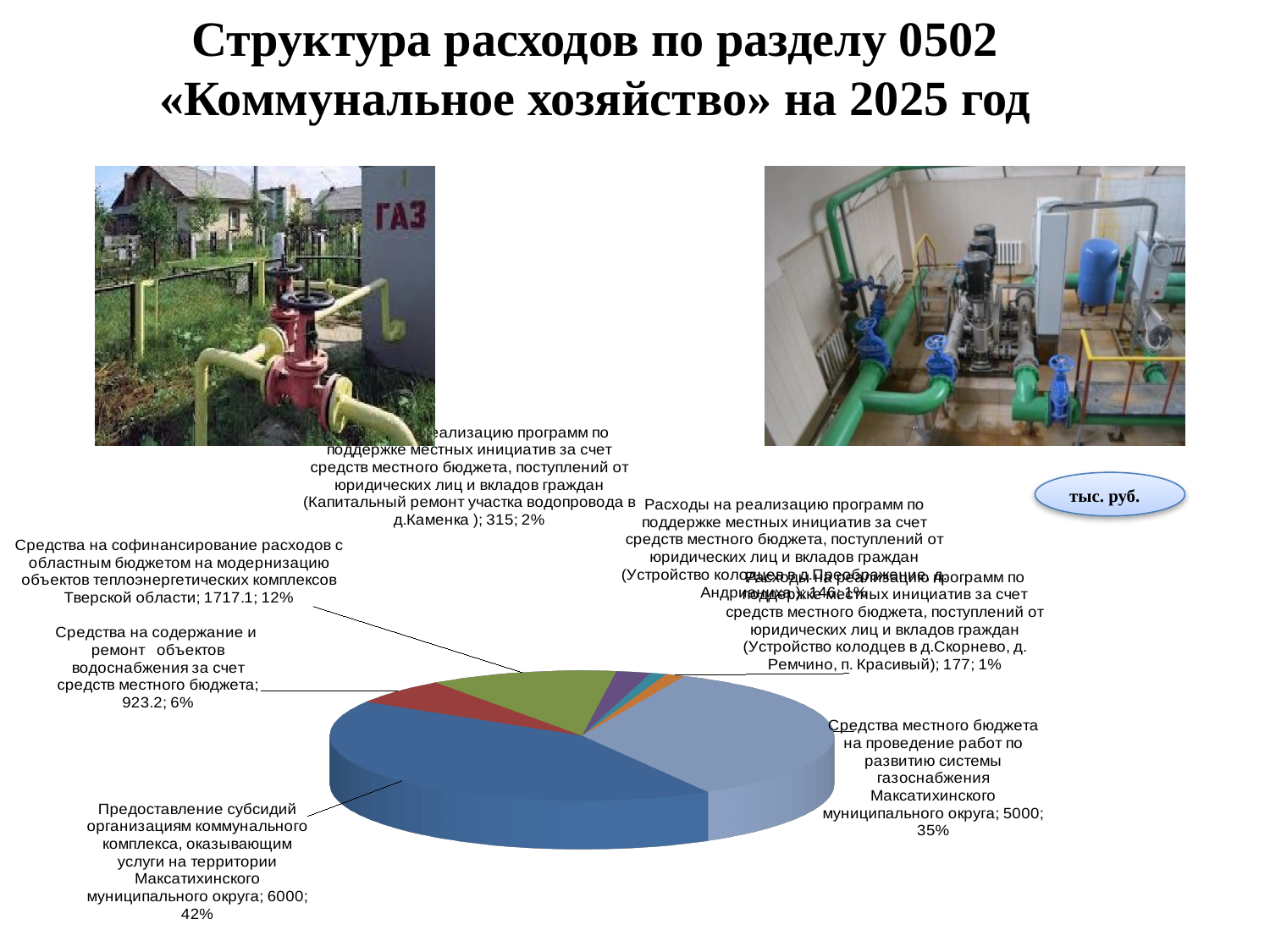
What is the difference between the value for «Предоставление субсидий организациям коммунального комплекса» and the value for «Средства местного бюджета на проведение работ по развитию системы газоснабжения»? 1000 What share of the pie does «Средства местного бюджета на проведение работ по развитию системы газоснабжения Максатихинского муниципального округа» represent? 35% What is the value for «Средства на софинансирование расходов с областным бюджетом на модернизацию объектов теплоэнергетических комплексов Тверской области»? 1717.1 What is the value for «Предоставление субсидий организациям коммунального комплекса, оказывающим услуги на территории Максатихинского муниципального округа»? 6000 What kind of chart is shown on the slide? pie chart What is the value for the slice labelled «Устройство колодцев в д.Скорнево, д. Ремчино, п. Красивый»? 177 Which is larger: the value for «Средства на софинансирование расходов с областным бюджетом на модернизацию объектов теплоэнергетических комплексов Тверской области» or the value for «Средства на содержание и ремонт объектов водоснабжения за счет средств местного бюджета»? Средства на софинансирование расходов с областным бюджетом на модернизацию объектов теплоэнергетических комплексов Тверской области What is the value for «Средства на содержание и ремонт объектов водоснабжения за счет средств местного бюджета»? 923.2 What is the value for the slice labelled «Капитальный ремонт участка водопровода в д.Каменка»? 315 Which category has the largest share of the pie? Предоставление субсидий организациям коммунального комплекса, оказывающим услуги на территории Максатихинского муниципального округа In what units are the values on the chart given, according to the slide? тыс. руб. What is the value for «Средства местного бюджета на проведение работ по развитию системы газоснабжения Максатихинского муниципального округа»? 5000